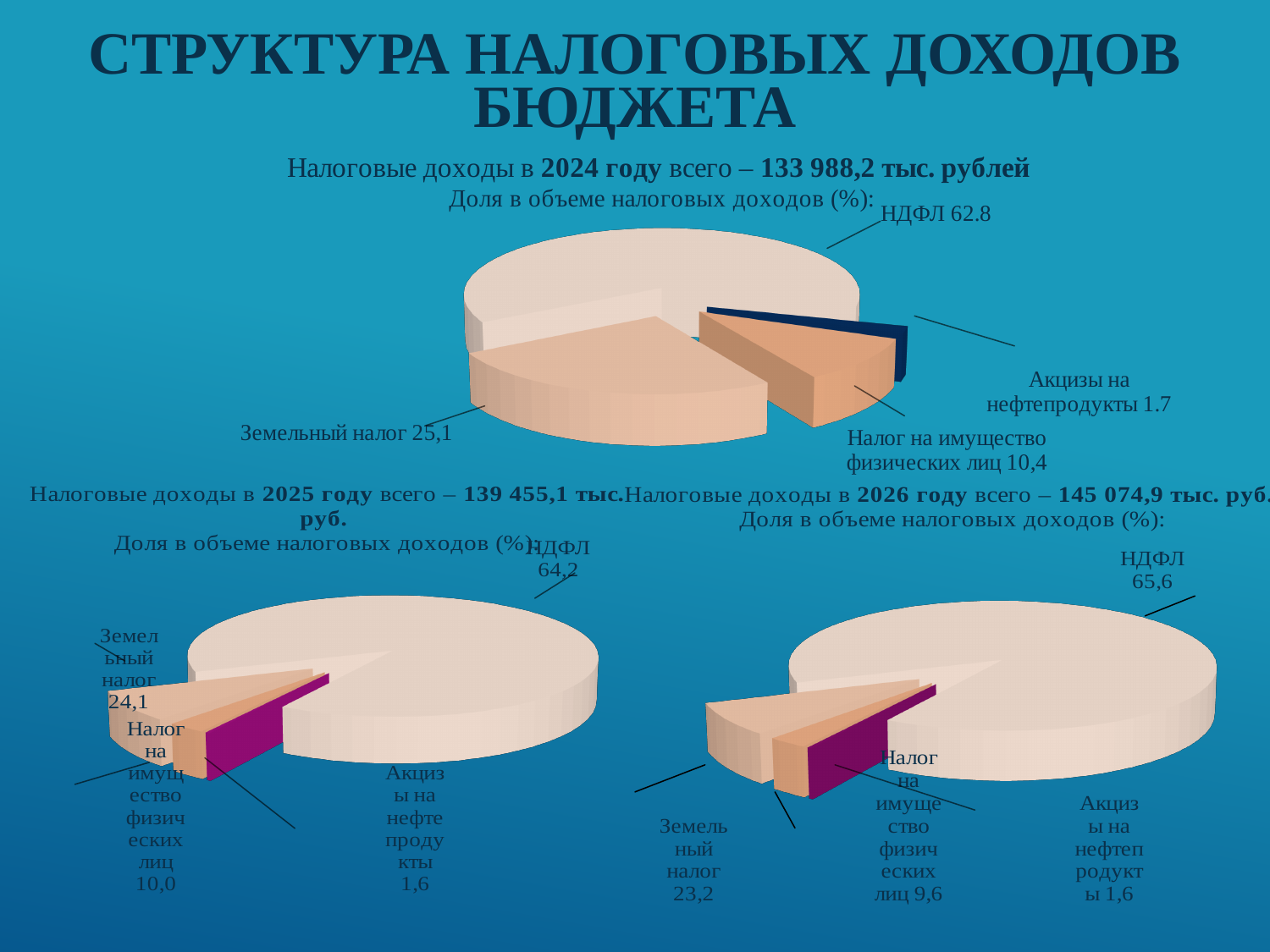
In the 2024 pie chart, what share is shown for НДФЛ? 62.8 In the 2026 pie chart, what share is shown for Акцизы на нефтепродукты? 1,6 In the 2024 pie chart, which category has the largest share? НДФЛ In the 2026 pie chart, what share is shown for Земельный налог? 23,2 In the 2024 pie chart, what share is shown for Земельный налог? 25,1 In the 2025 pie chart, what share is shown for Налог на имущество физических лиц? 10,0 How many pie charts are shown on the slide? 3 What type of chart is used for the 2026 data? Pie chart In the 2026 pie chart, what is the difference between the shares of НДФЛ and Земельный налог? 42,4 In the 2024 pie chart, which is larger: the share of Земельный налог or the share of Налог на имущество физических лиц? Земельный налог How many slices does the 2025 pie chart have? 4 In the 2025 pie chart, which category has the smallest share? Акцизы на нефтепродукты